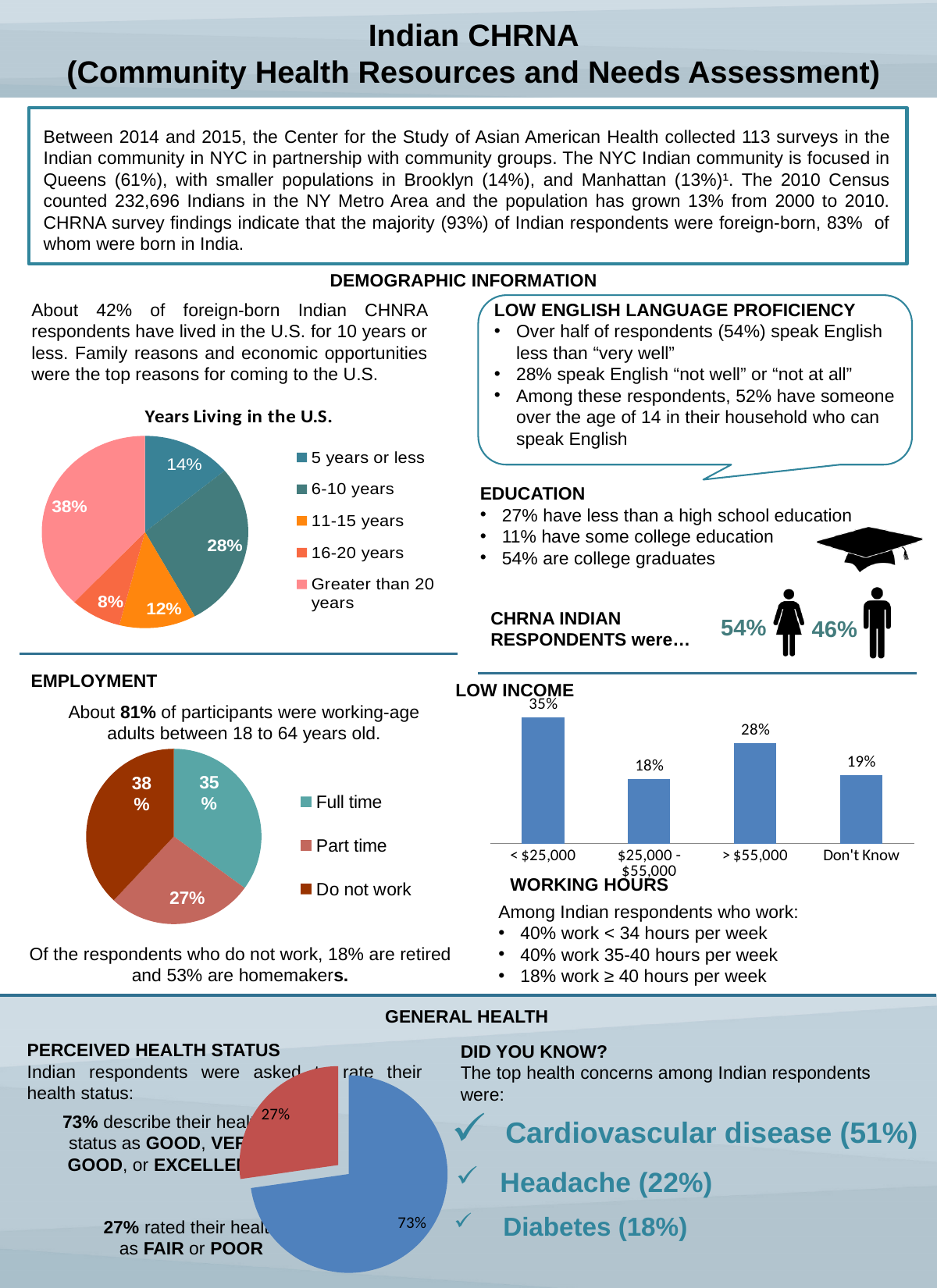
In the Employment pie chart, what percentage of participants work part time? 27% In the Perceived Health Status pie chart, what is the value of the larger slice? 73% In the Low Income bar chart, what is the difference between the "< $25,000" value and the "Don't Know" value? 16% In the Low Income bar chart, what is the value for the "> $55,000" category? 28% In the "Years Living in the U.S." pie chart, what is the difference between the 6-10 years share and the 11-15 years share? 16% What kind of chart is used in the Low Income section? Bar chart In the Employment pie chart, which category has the largest share? Do not work In the Low Income bar chart, which income category has the highest value? < $25,000 In the Employment pie chart, which is larger: Full time or Part time? Full time In the "Years Living in the U.S." pie chart, how many categories does the legend list? 5 In the "Years Living in the U.S." pie chart, what share of respondents have lived in the U.S. for greater than 20 years? 38% In the "Years Living in the U.S." pie chart, which category has the smallest share? 16-20 years